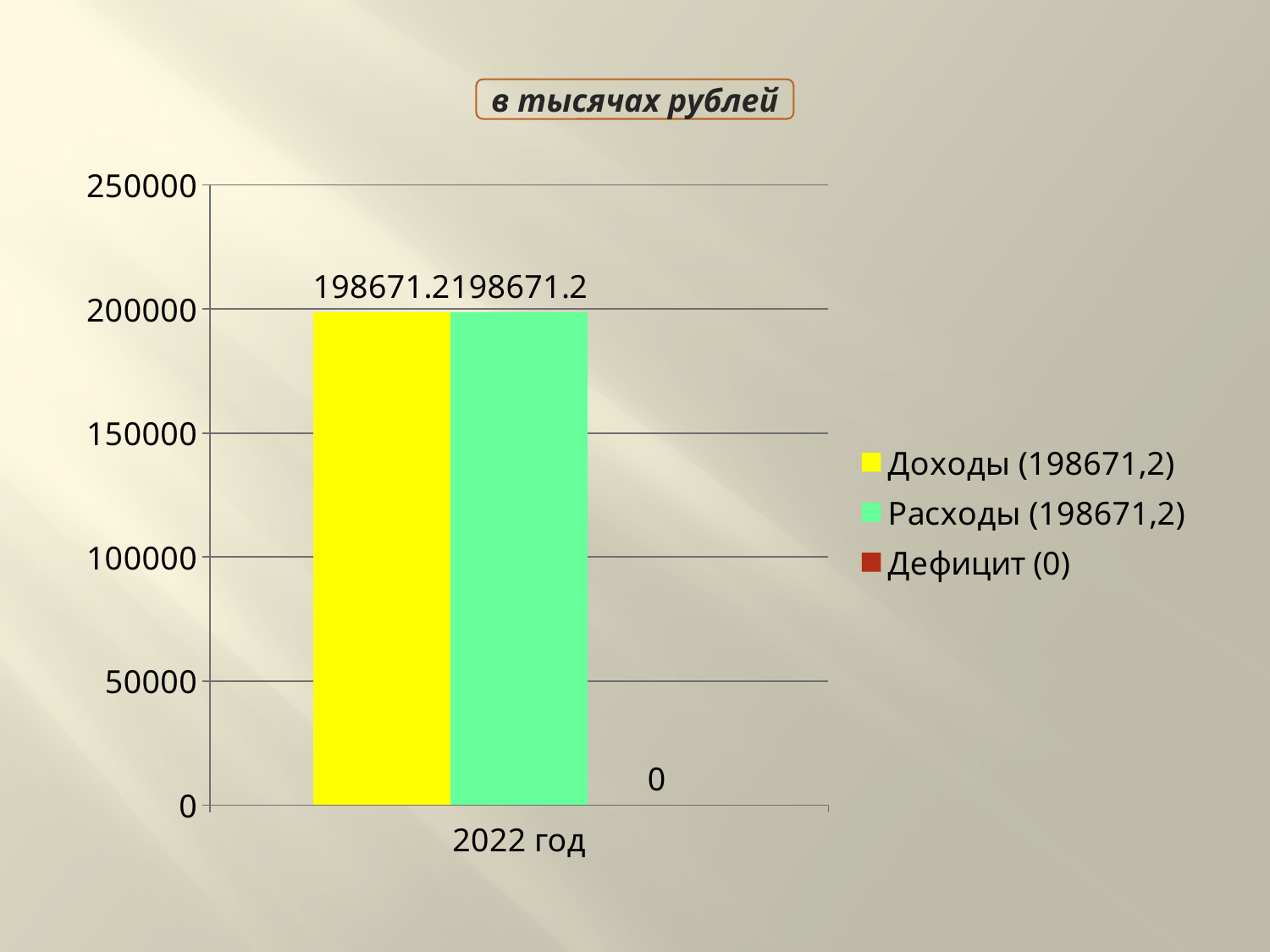
How many series does the legend list? 3 What unit is stated in the box above the chart? в тысячах рублей What is the value of Дефицит for 2022 год? 0 How many categories are shown on the x axis? 1 What colour is the bar for Доходы? yellow Which series has the lowest value for 2022 год? Дефицит What is the value of Доходы for 2022 год? 198671.2 Is the value for Доходы greater or less than 150000? greater What is the difference between Доходы and Расходы for 2022 год? 0 What kind of chart is shown on the slide? bar chart What is the value of Расходы for 2022 год? 198671.2 Is the value for Расходы greater or less than 200000? less